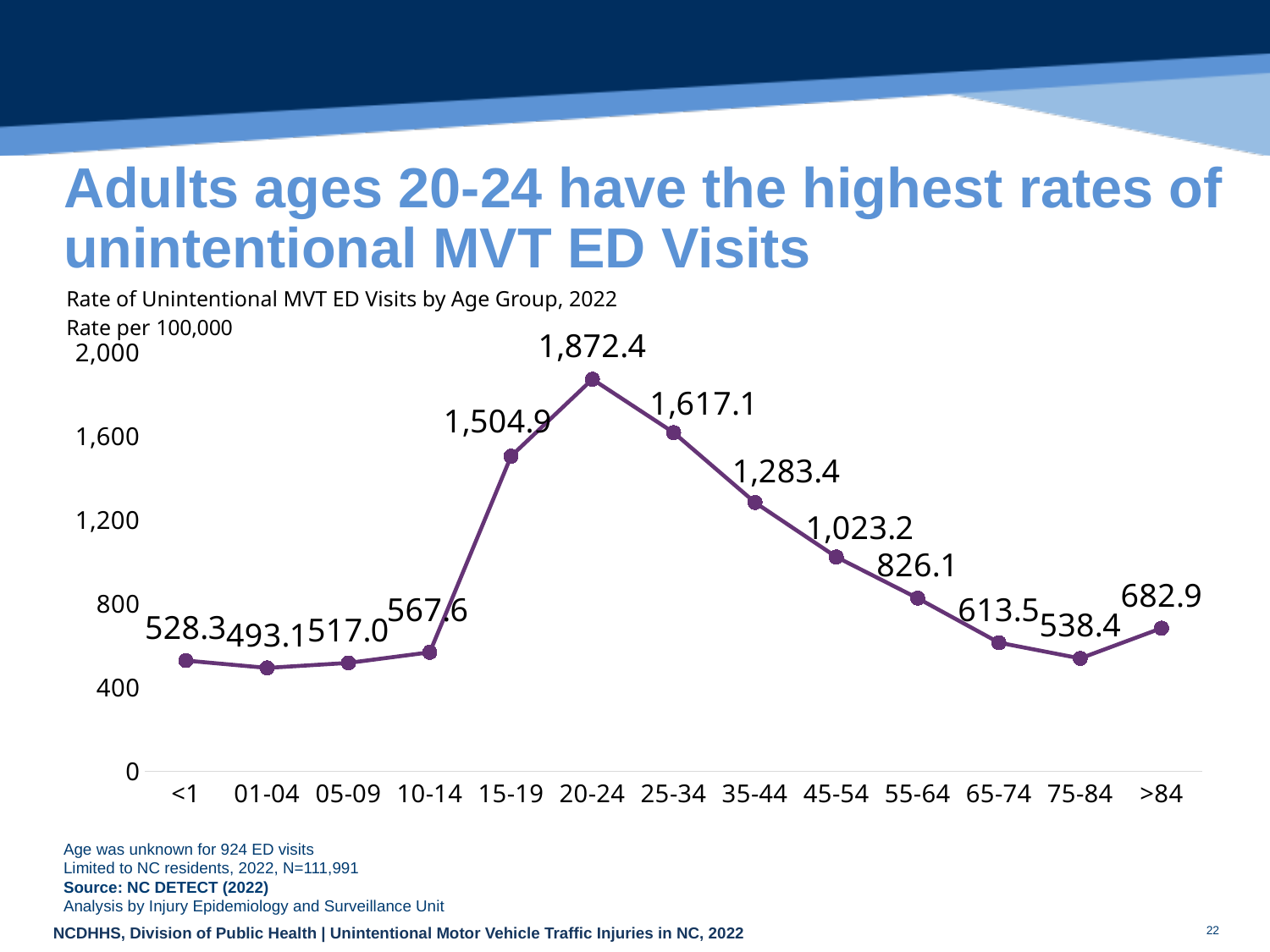
Which age group has the lowest rate of unintentional MVT ED visits? 01-04 What is the difference between the rates for the 15-19 and 10-14 age groups? 937.3 What type of chart is shown on the slide? Line chart What is the rate for the 55-64 age group? 826.1 What is the difference between the rates for the 20-24 and 25-34 age groups? 255.3 Which age group has a higher rate, 35-44 or 45-54? 35-44 What is the rate for the >84 age group? 682.9 Is the rate for the 65-74 age group greater or less than 800? less How many age groups are plotted on the chart? 13 Do the rates rise or fall from the 20-24 age group to the 75-84 age group? Fall Which age group has the highest rate of unintentional MVT ED visits? 20-24 What is the rate of unintentional MVT ED visits for the 20-24 age group? 1,872.4